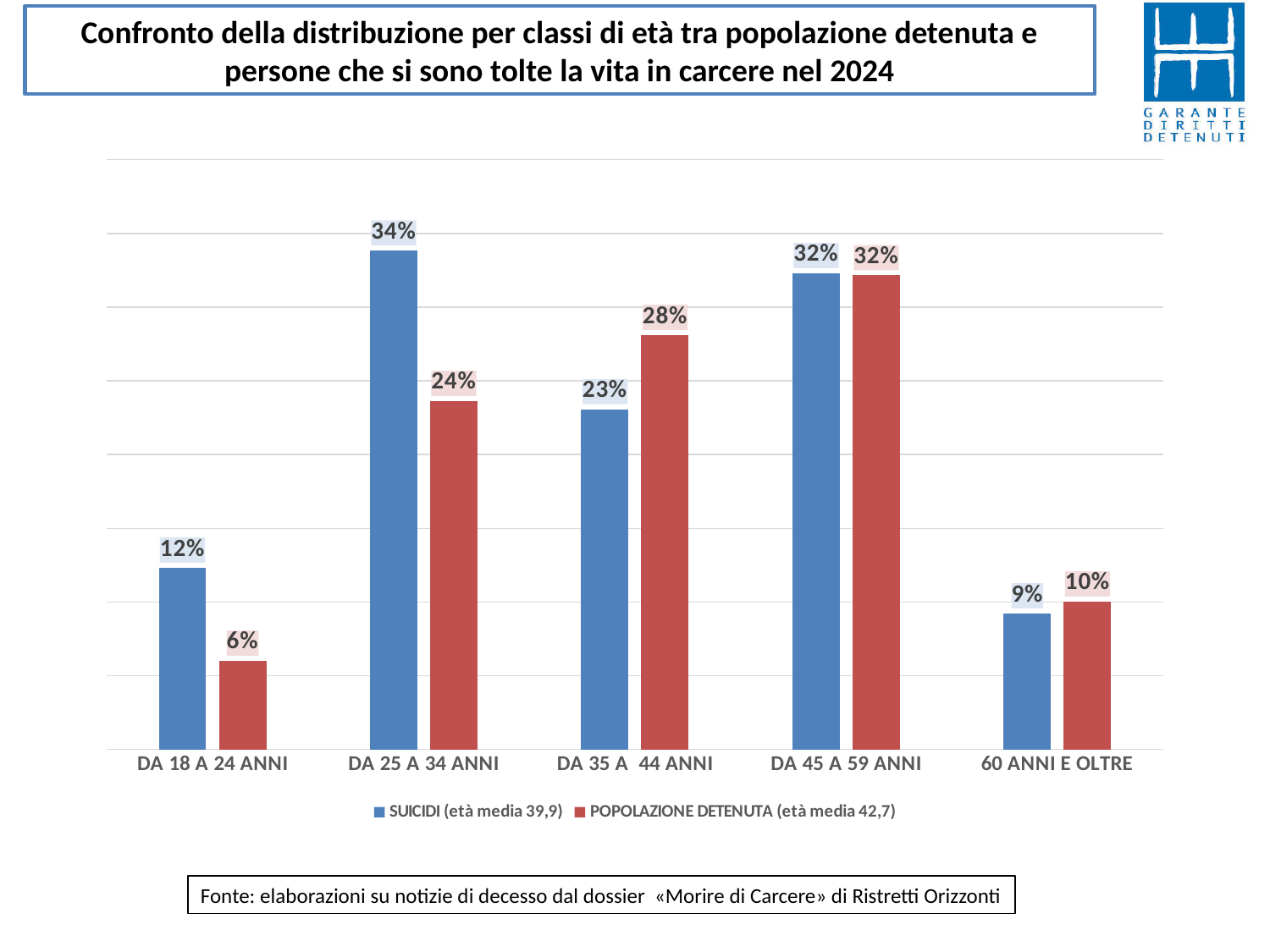
What is the SUICIDI value for DA 25 A 34 ANNI? 34% How many series does the legend list? 2 How many age classes are shown on the x axis? 5 What is the POPOLAZIONE DETENUTA value for DA 35 A 44 ANNI? 28% What is the difference between the POPOLAZIONE DETENUTA and SUICIDI values for DA 35 A 44 ANNI? 5% Which age class has the lowest POPOLAZIONE DETENUTA value? DA 18 A 24 ANNI What kind of chart is shown on the slide? Bar chart For DA 18 A 24 ANNI, which series has the larger value, SUICIDI or POPOLAZIONE DETENUTA? SUICIDI What is the POPOLAZIONE DETENUTA value for DA 18 A 24 ANNI? 6% What is the difference between the SUICIDI and POPOLAZIONE DETENUTA values for DA 25 A 34 ANNI? 10% Which age class has the highest SUICIDI value? DA 25 A 34 ANNI What colour are the bars for the POPOLAZIONE DETENUTA series? Red